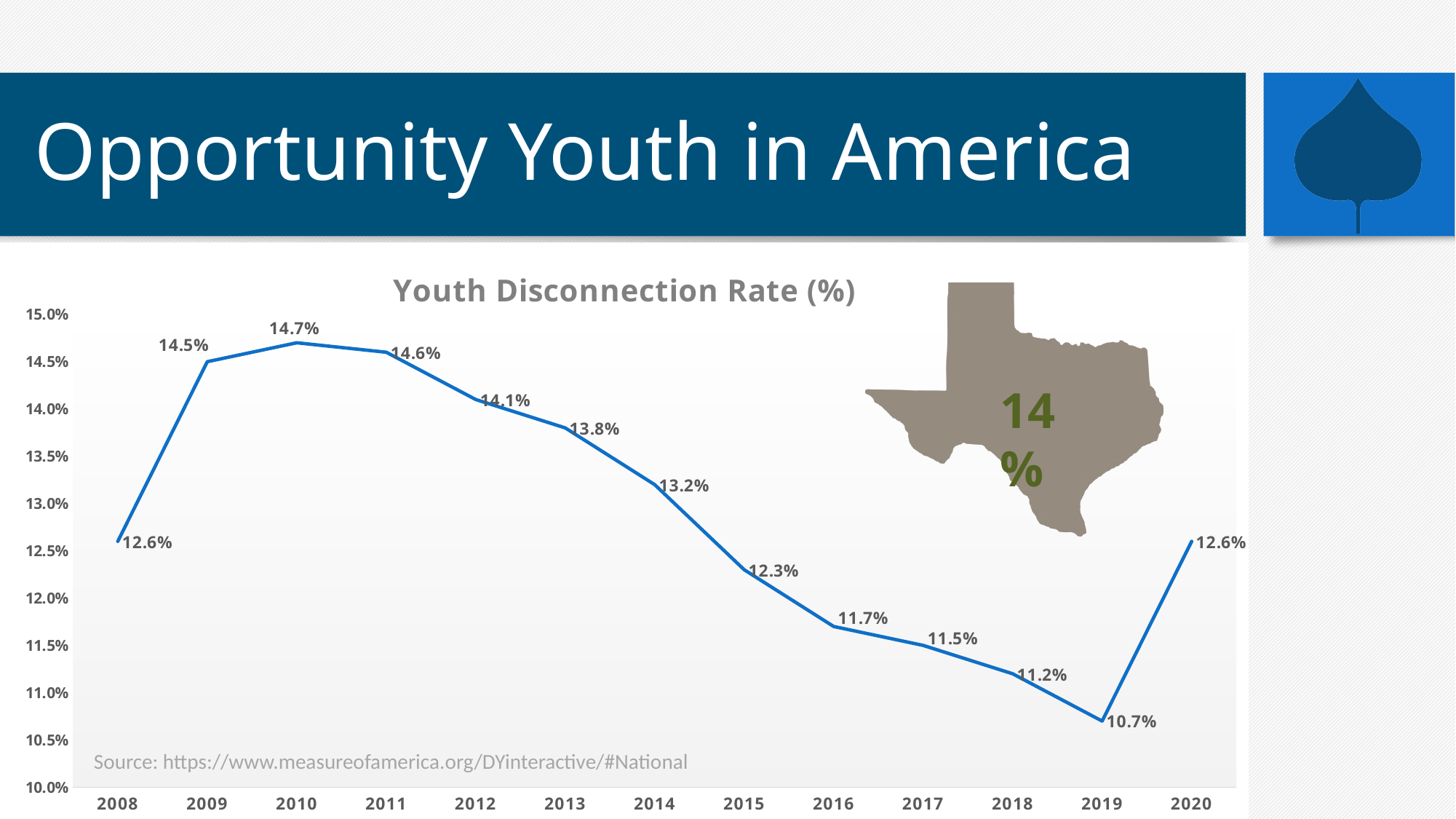
Does the youth disconnection rate rise or fall from 2010 to 2019? fall Which year has the highest youth disconnection rate? 2010 Which year has the lowest youth disconnection rate? 2019 Is the youth disconnection rate in 2014 greater or less than 13.0%? greater Which year has a higher youth disconnection rate, 2013 or 2017? 2013 How many years are plotted on the chart? 13 What is the youth disconnection rate in 2019? 10.7% What is the difference between the youth disconnection rate in 2010 and in 2019? 4.0% What is the title of the chart? Youth Disconnection Rate (%) What is the youth disconnection rate in 2015? 12.3% What is the youth disconnection rate in 2010? 14.7% What kind of chart is shown on the slide? line chart